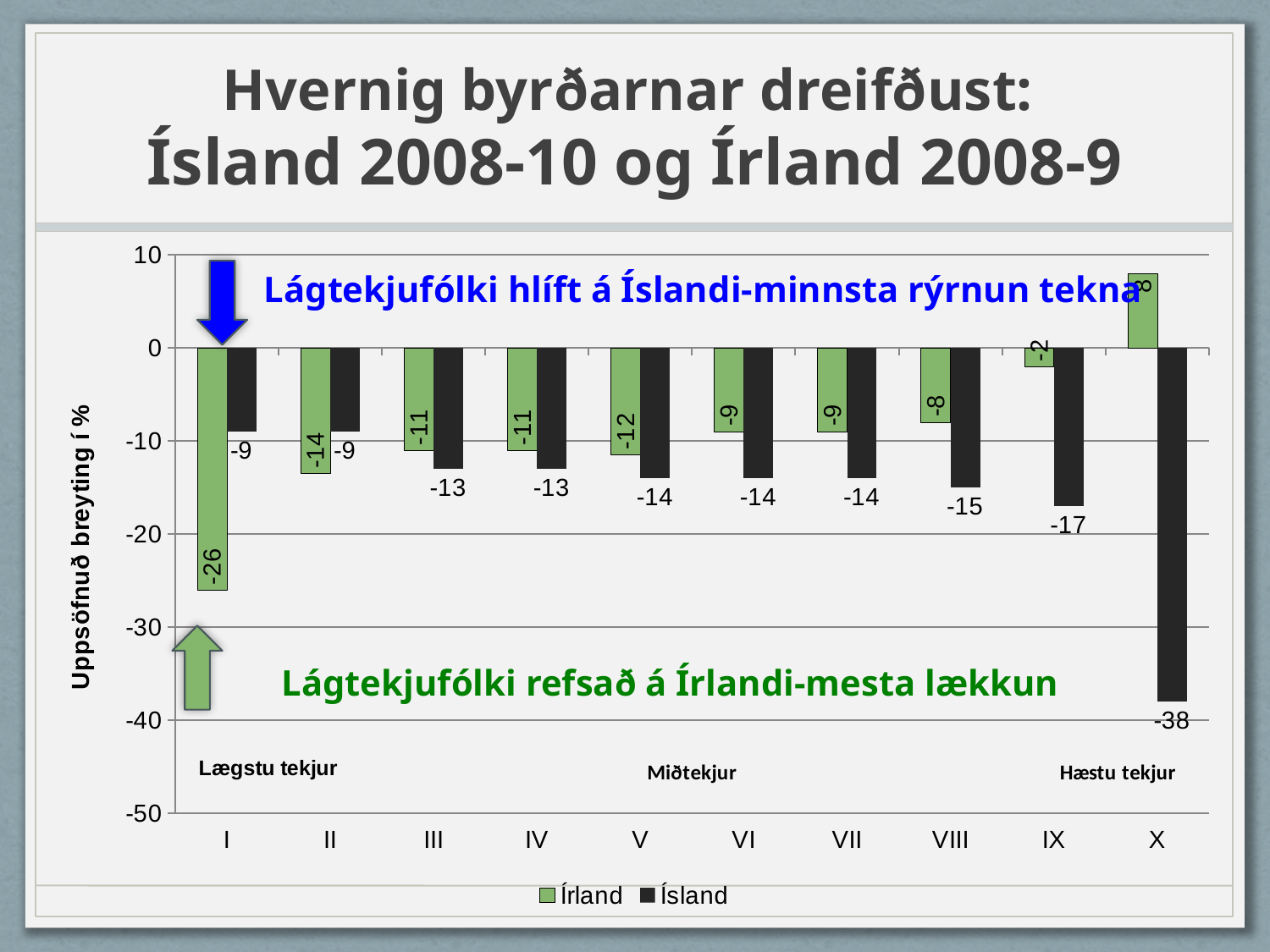
Which category has the lowest value for the Ísland series? X How many categories are shown on the x axis? 10 Is the value for Írland in category X greater or less than 5? greater How many series does the legend list? 2 What is the value for Ísland in category IX? -17 What is the difference between the Írland and Ísland values in category I? 17 Which category has the lowest value for the Írland series? I Which category has the highest value for the Írland series? X What is the value for Ísland in category X? -38 What kind of chart is shown on the slide? bar chart What is the value for Írland in category I? -26 In category II, which series has the larger value, Írland or Ísland? Ísland